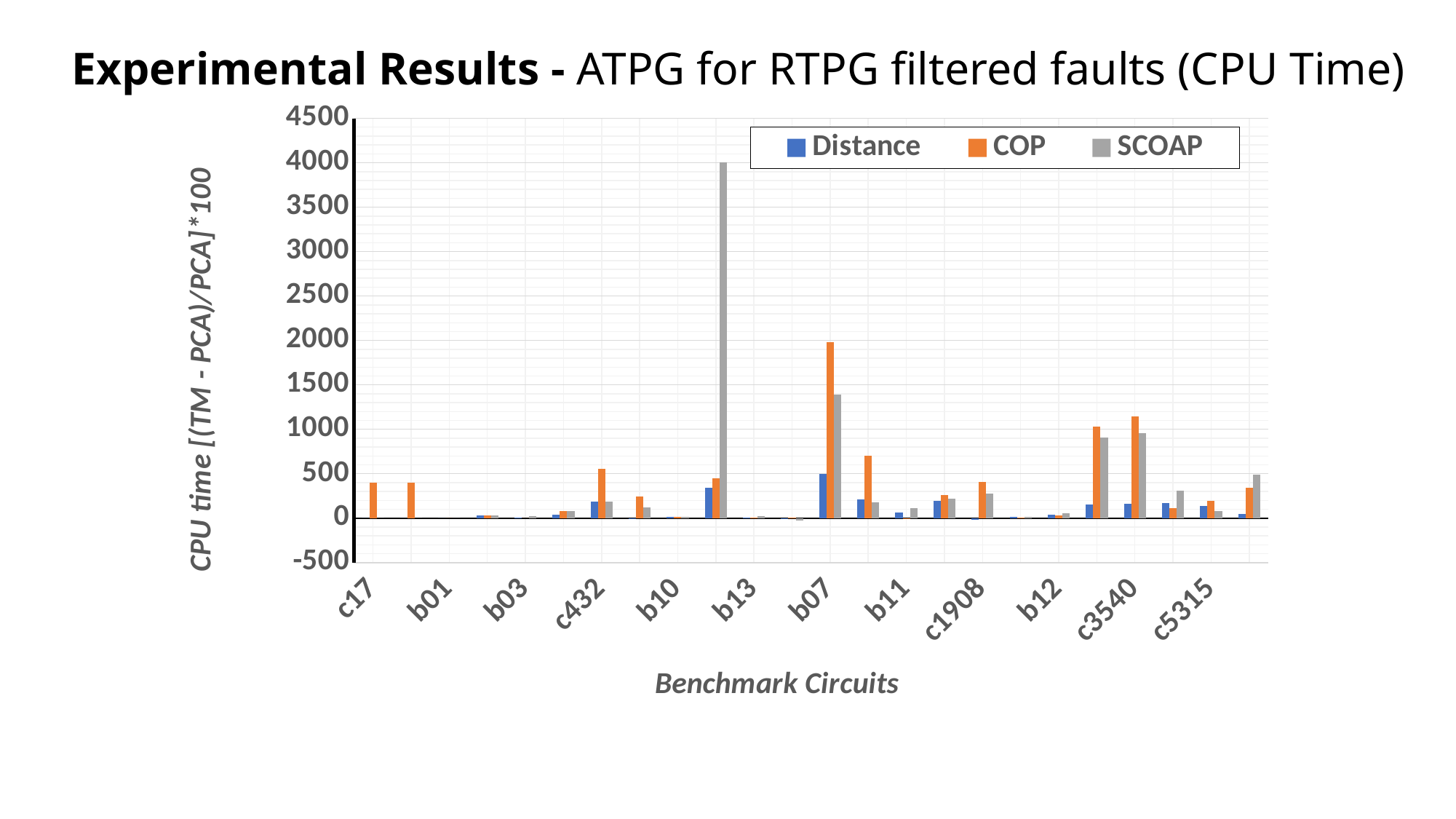
Which series is drawn in orange? COP Is the tallest COP bar greater or less than 1500? greater Is the tallest COP bar greater or less than 2500? less How many series does the legend list? 3 Is the tallest bar in the chart greater or less than 3500? greater What are the three series named in the legend? Distance, COP, SCOAP Which series has the second tallest bar in the chart? COP Which series has the tallest bar in the chart? SCOAP What is the highest value shown on the vertical axis? 4500 What is the lowest value shown on the vertical axis? -500 What kind of chart is shown on the slide? bar chart